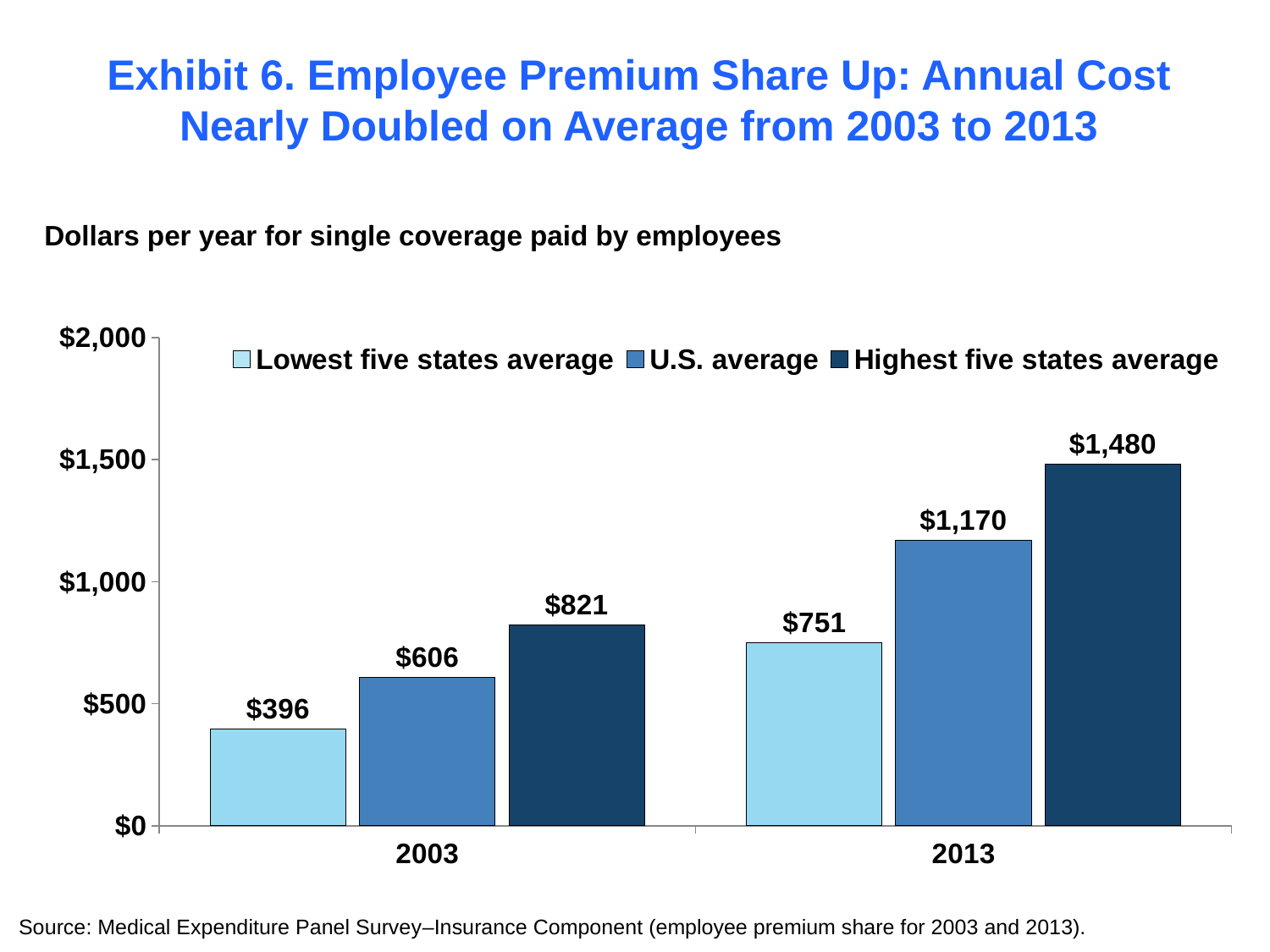
What is the lowest five states average value for 2003? $396 Which series has the lowest value in 2003? Lowest five states average How many series does the legend list? 3 What is the U.S. average employee premium share for single coverage in 2013? $1,170 What is the difference between the U.S. average in 2013 and the U.S. average in 2003? $564 How many years are shown on the x axis? 2 Which series has the highest value in 2013? Highest five states average Which is larger: the lowest five states average in 2013 or the U.S. average in 2003? Lowest five states average in 2013 What kind of chart is shown on the slide? Bar chart What is the highest five states average value for 2003? $821 What is the difference between the highest five states average and the lowest five states average in 2013? $729 Does the U.S. average rise or fall from 2003 to 2013? Rise